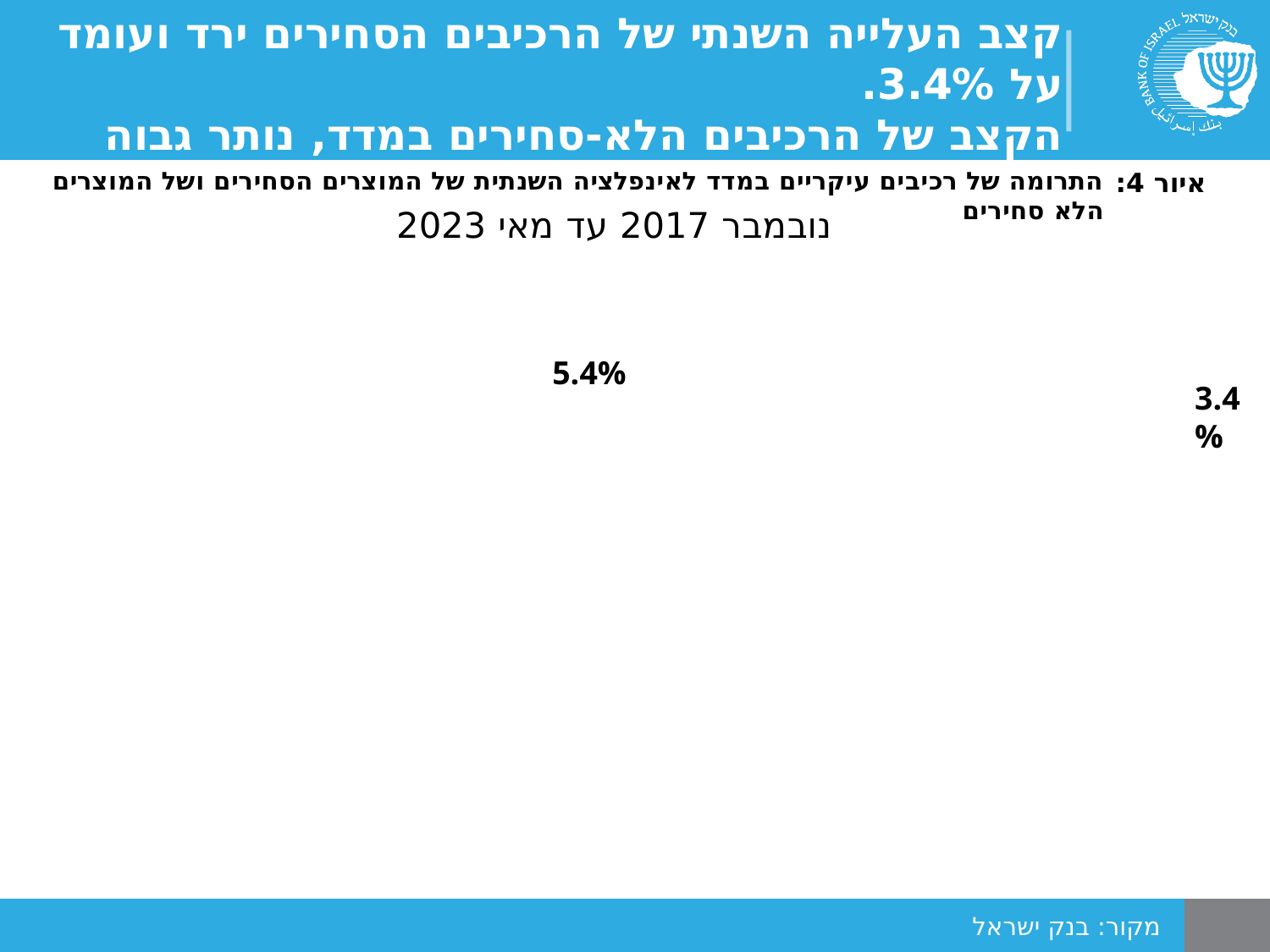
What is the figure number given in the caption above the chart? איור 4 Which printed data label is larger, 5.4% or 3.4%? 5.4% What is the difference between the two data labels printed on the chart, 5.4% and 3.4%? 2.0 percentage points What source is cited at the bottom of the slide? בנק ישראל According to the slide headline, at what annual rate does the increase of the tradable components (הרכיבים הסחירים) stand? 3.4% What is the title printed above the chart? נובמבר 2017 עד מאי 2023 Is the data label 5.4% on the chart greater or less than 5%? greater What is the lowest value printed as a data label on the chart? 3.4% How many data labels are printed on the chart? 2 What is the highest value printed as a data label on the chart? 5.4%